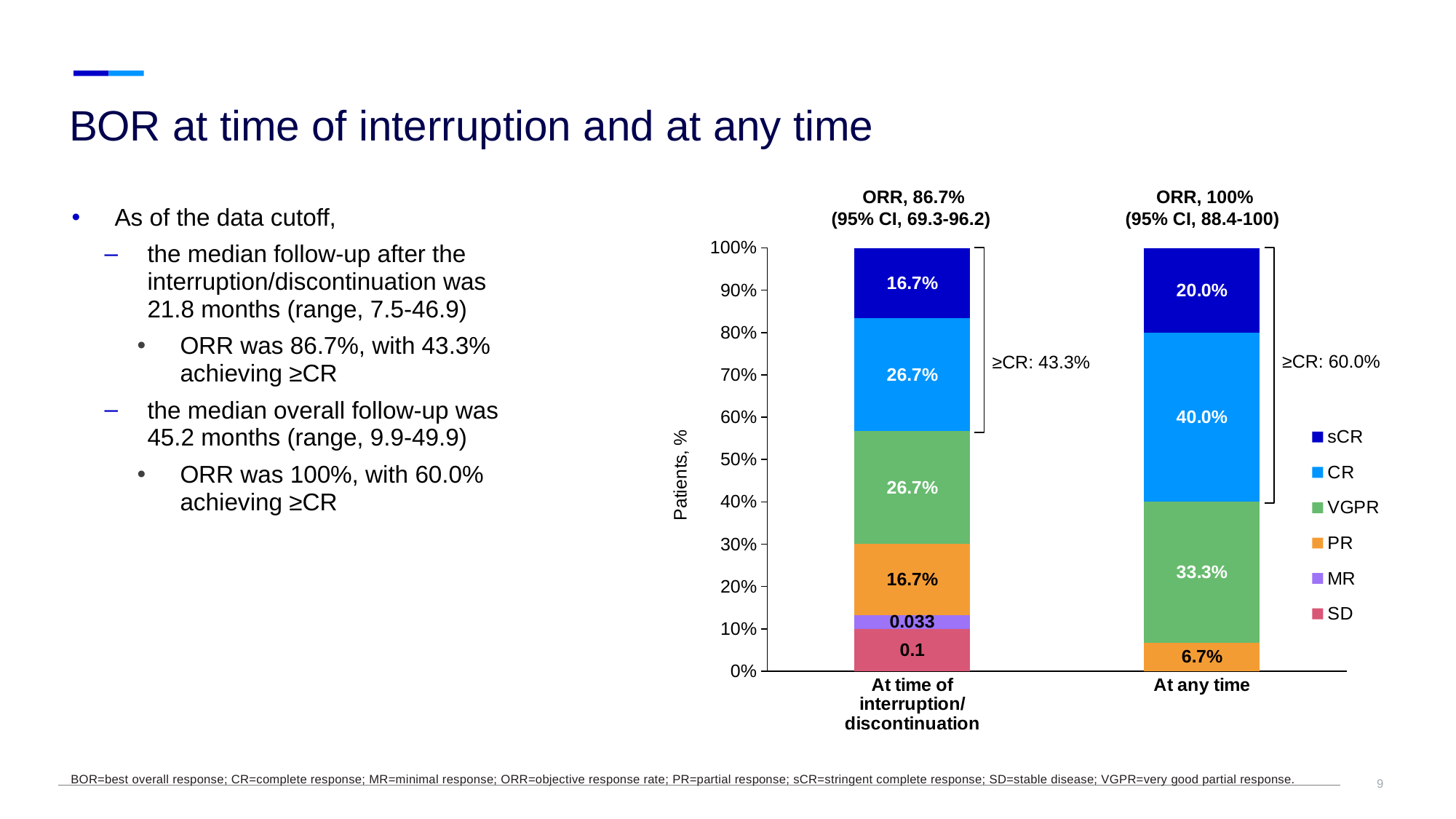
What is the CR value for the 'At time of interruption/discontinuation' bar? 26.7% What label is printed on the SD segment of the 'At time of interruption/discontinuation' bar? 0.1 Which bar has the larger CR segment, 'At time of interruption/discontinuation' or 'At any time'? At any time What is the PR value for the 'At any time' bar? 6.7% What is the difference between the sCR values for 'At any time' and 'At time of interruption/discontinuation'? 3.3% What is the sCR value for the 'At any time' bar? 20.0% Which response category has the largest segment in the 'At any time' bar? CR What ≥CR value is annotated next to the 'At any time' bar? 60.0% How many bars (categories) are plotted on the x axis? 2 What is the VGPR value for the 'At any time' bar? 33.3% How many series does the legend list? 6 What kind of chart is shown on the slide? stacked bar chart